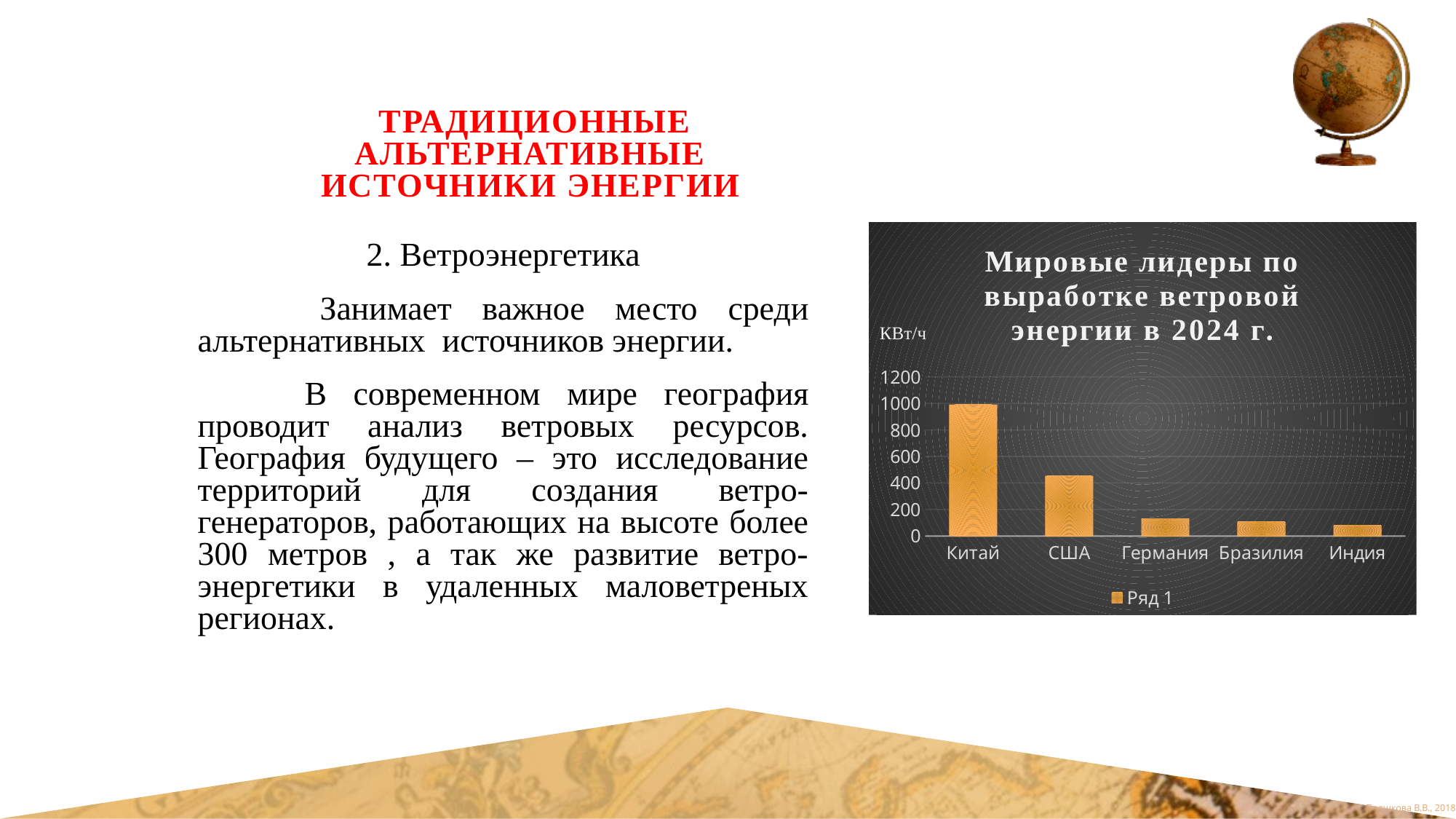
Which is larger, the value for Китай or the value for США? Китай Is the value for Китай greater or less than 800? greater Do the values rise or fall from left to right across the countries? fall Which is larger, the value for США or the value for Германия? США How many countries are shown on the chart? 5 What kind of chart is shown on the slide? bar chart What is the title of the chart? Мировые лидеры по выработке ветровой энергии в 2024 г. Is the value for США greater or less than 600? less How many series does the legend list? 1 Which country has the highest value on the chart? Китай Is the value for Германия greater or less than 200? less What is the name of the series shown in the legend? Ряд 1